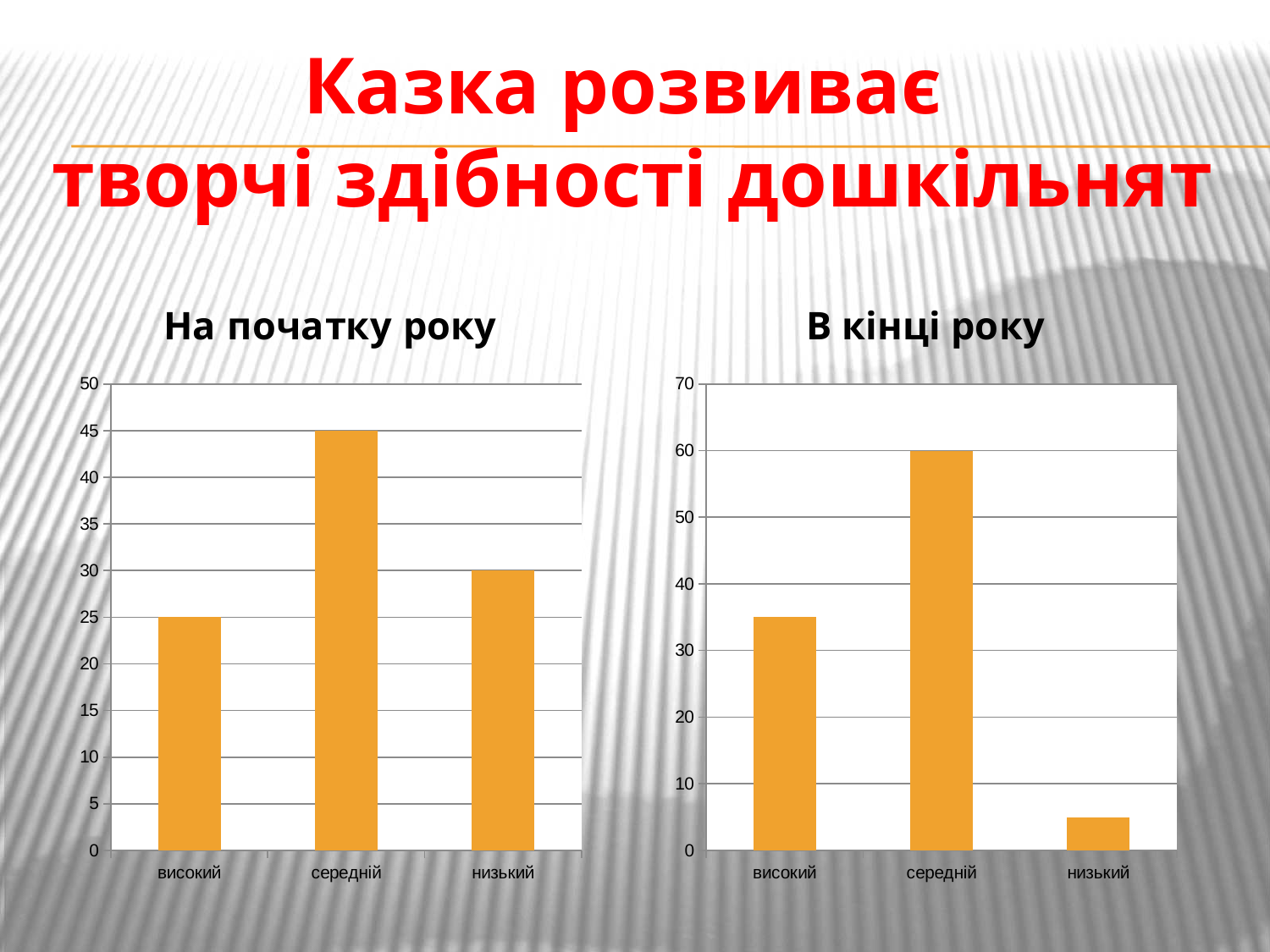
In the chart titled "В кінці року", is the value for високий greater or less than 30? greater In the chart titled "В кінці року", which category has the lowest value? низький In the chart titled "На початку року", what is the value for середній? 45 In the chart titled "На початку року", which category has the lowest value? високий In the chart titled "В кінці року", is the value for низький greater or less than 10? less In the chart titled "В кінці року", what is the value for середній? 60 How many categories are shown in the chart titled "В кінці року"? 3 In the chart titled "На початку року", what is the value for низький? 30 What type of chart is the chart titled "На початку року"? bar chart In the chart titled "На початку року", what is the value for високий? 25 In the chart titled "На початку року", what is the difference between the values for середній and високий? 20 In the chart titled "На початку року", which category has the highest value? середній